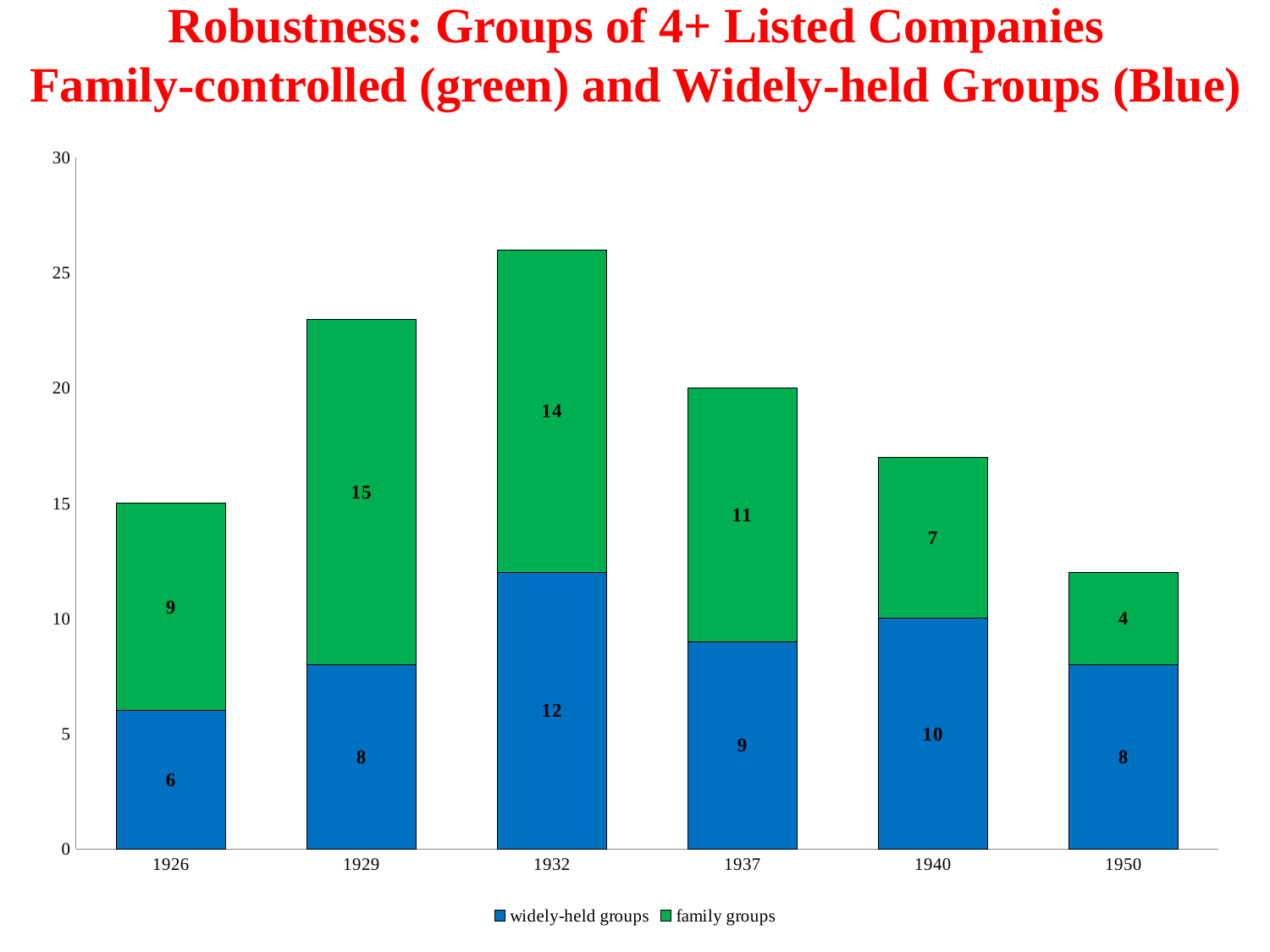
What is the value for family groups in 1950? 4 Which year has the highest value for family groups? 1929 What is the total of the stacked bar for 1926? 15 How many series does the legend list? 2 How many years are shown on the x axis? 6 What kind of chart is shown on the slide? stacked bar chart Which is larger in 1940: the widely-held groups value or the family groups value? widely-held groups What is the value for family groups in 1929? 15 Which year has the lowest value for widely-held groups? 1926 What is the difference between the family groups value and the widely-held groups value in 1937? 2 What is the value for widely-held groups in 1932? 12 What is the total of the stacked bar for 1932? 26